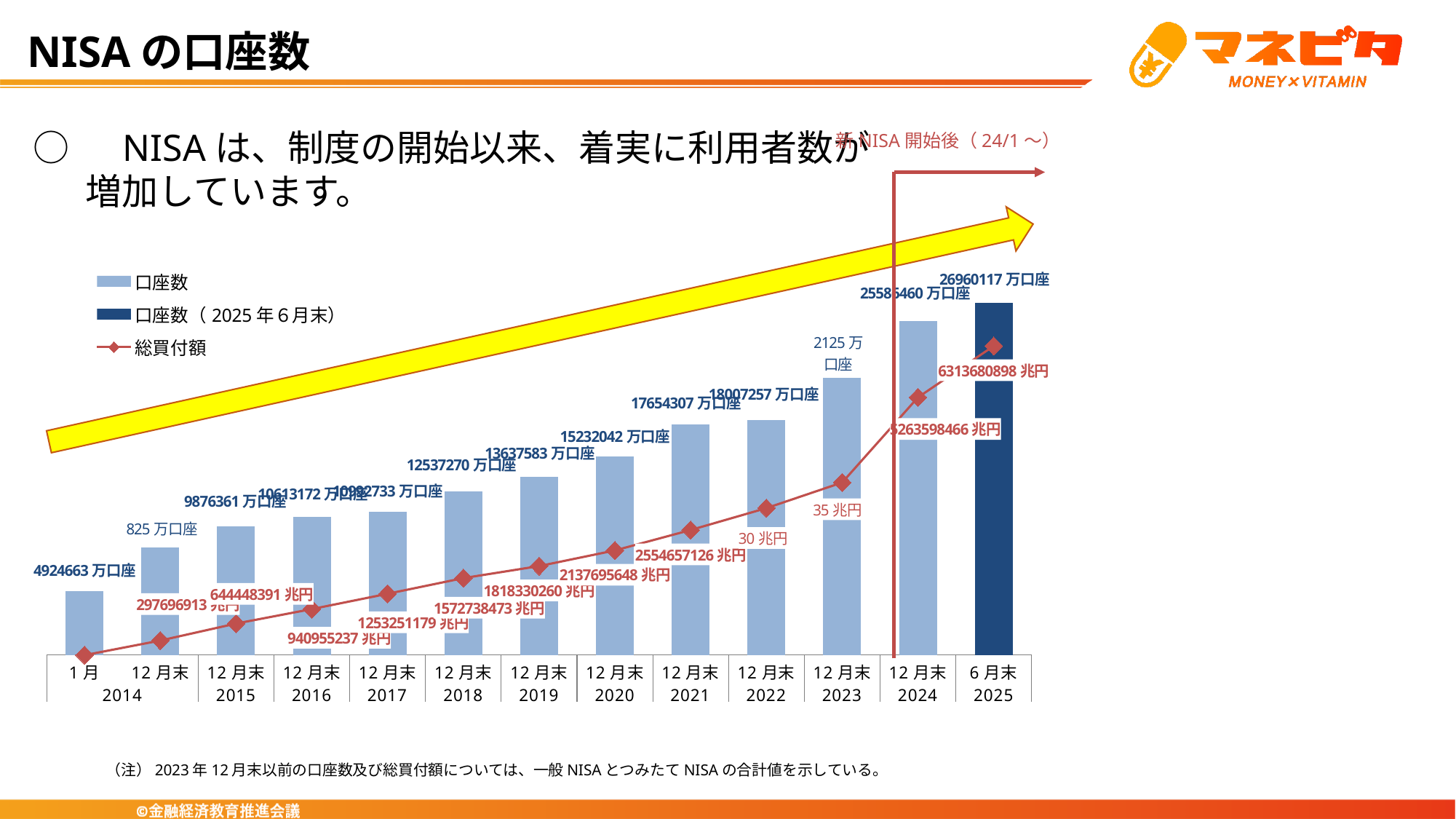
Do the 総買付額 values rise or fall from 2014 to 2025? rise What is the 総買付額 value labelled for 6月末 2025? 6313680898 兆円 Which period has the shortest 口座数 bar? 1月 2014 What is the difference between the 総買付額 values for 12月末 2023 and 12月末 2022? 5 兆円 What is the number of accounts labelled for 12月末 2023? 2125 万口座 What is the number of accounts shown for 6月末 2025? 26960117 万口座 Which has the taller 口座数 bar, 12月末 2021 or 12月末 2022? 12月末 2022 Which period has the tallest 口座数 bar? 6月末 2025 How many time periods are shown on the x axis? 13 What is the 総買付額 value labelled for 12月末 2022? 30 兆円 What is the number of accounts labelled for 1月 2014? 4924663 万口座 How many series does the legend list? 3